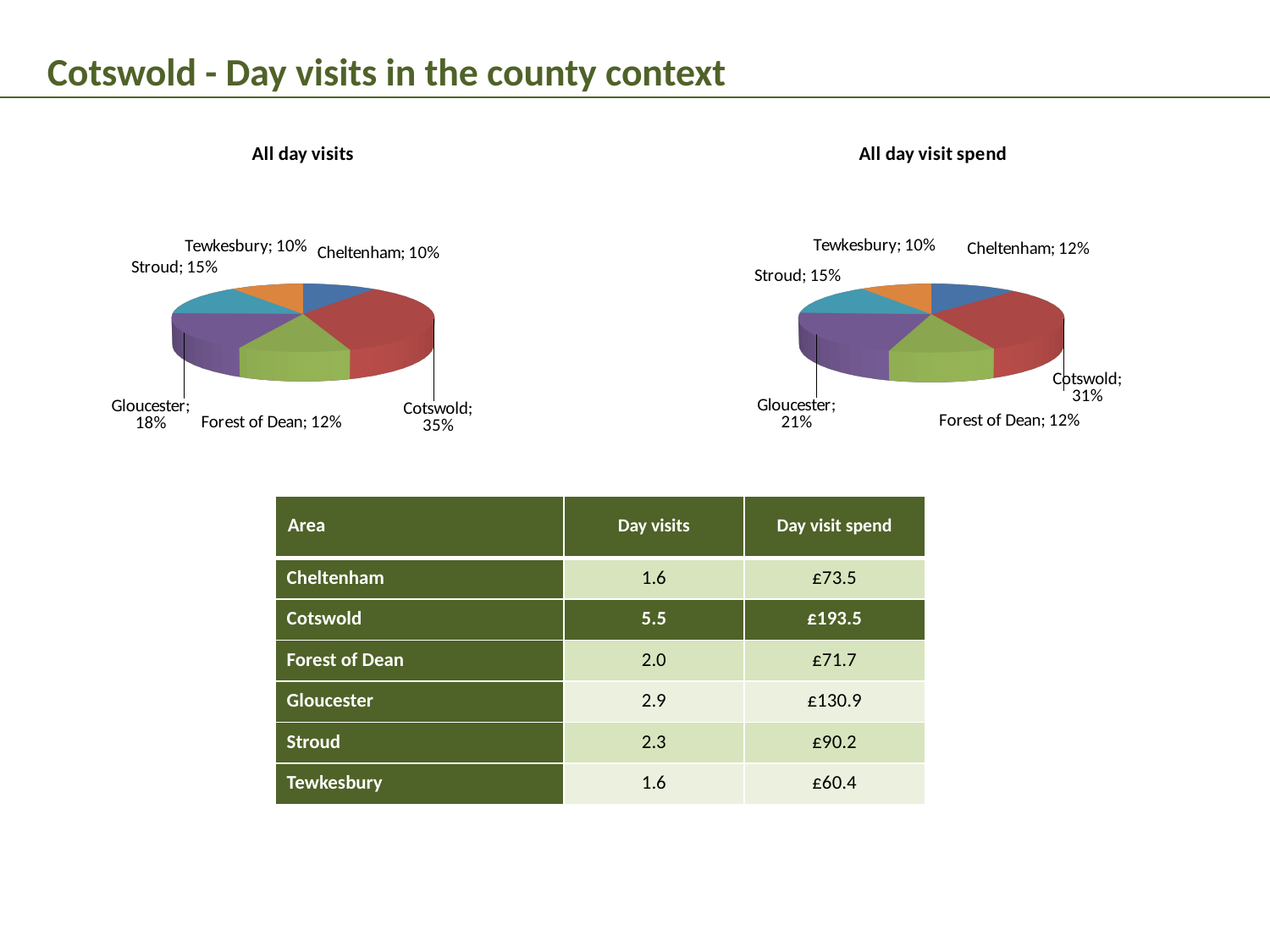
In the 'All day visits' chart, what is the difference between the Cotswold share and the Gloucester share? 17% In the 'All day visit spend' chart, which area has the smallest share? Tewkesbury What type of chart is the 'All day visit spend' chart? Pie chart In the 'All day visits' chart, what share does Cotswold have? 35% In the 'All day visits' chart, which area has the largest share? Cotswold What is the title of the chart on the left of the slide? All day visits In the 'All day visit spend' chart, what share does Cheltenham have? 12% In the 'All day visit spend' chart, what is the difference between the Cotswold share and the Forest of Dean share? 19% In the 'All day visit spend' chart, what share does Gloucester have? 21% How many areas are shown in the 'All day visits' chart? 6 In the 'All day visit spend' chart, which is larger: the share for Gloucester or the share for Stroud? Gloucester In the 'All day visits' chart, which is larger: the share for Stroud or the share for Forest of Dean? Stroud